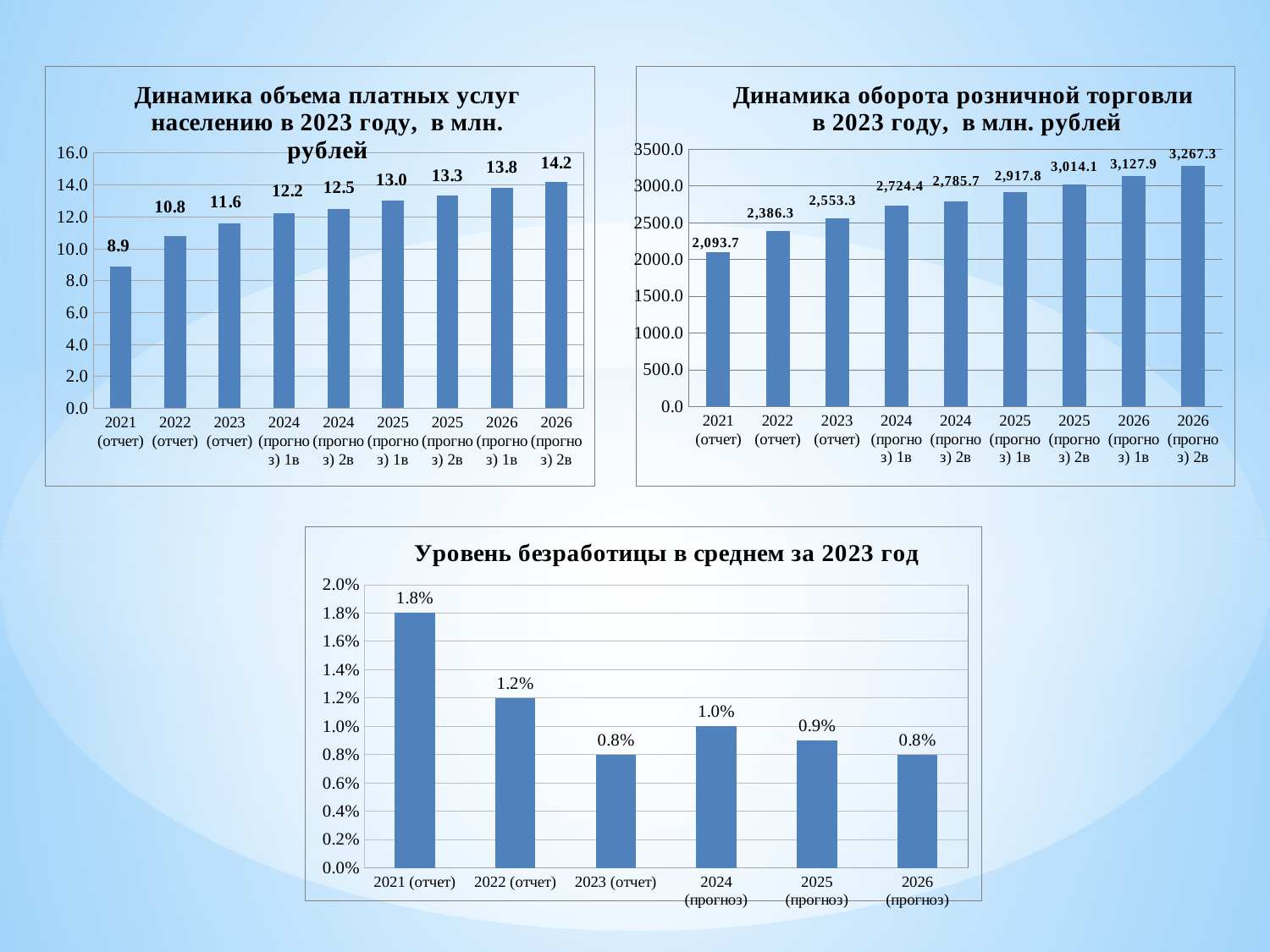
In the chart 'Динамика оборота розничной торговли в 2023 году, в млн. рублей', which is larger: the value for 2024 (прогноз) 2в or 2025 (прогноз) 1в? 2025 (прогноз) 1в In the chart 'Динамика оборота розничной торговли в 2023 году, в млн. рублей', which category has the lowest value? 2021 (отчет) What kind of chart is 'Уровень безработицы в среднем за 2023 год'? bar chart In the chart 'Динамика объема платных услуг населению в 2023 году, в млн. рублей', which category has the highest value? 2026 (прогноз) 2в In the chart 'Динамика объема платных услуг населению в 2023 году, в млн. рублей', how many bars are plotted? 9 In the chart 'Динамика оборота розничной торговли в 2023 году, в млн. рублей', do the values rise or fall from left to right along the x axis? rise In the chart 'Уровень безработицы в среднем за 2023 год', what is the difference between the values for 2021 (отчет) and 2024 (прогноз)? 0.8% In the chart 'Динамика оборота розничной торговли в 2023 году, в млн. рублей', what is the value for 2023 (отчет)? 2,553.3 In the chart 'Динамика объема платных услуг населению в 2023 году, в млн. рублей', what is the difference between the values for 2026 (прогноз) 2в and 2021 (отчет)? 5.3 In the chart 'Уровень безработицы в среднем за 2023 год', which category has the highest value? 2021 (отчет) In the chart 'Уровень безработицы в среднем за 2023 год', what is the value for 2022 (отчет)? 1.2% In the chart 'Динамика объема платных услуг населению в 2023 году, в млн. рублей', what is the value for 2021 (отчет)? 8.9